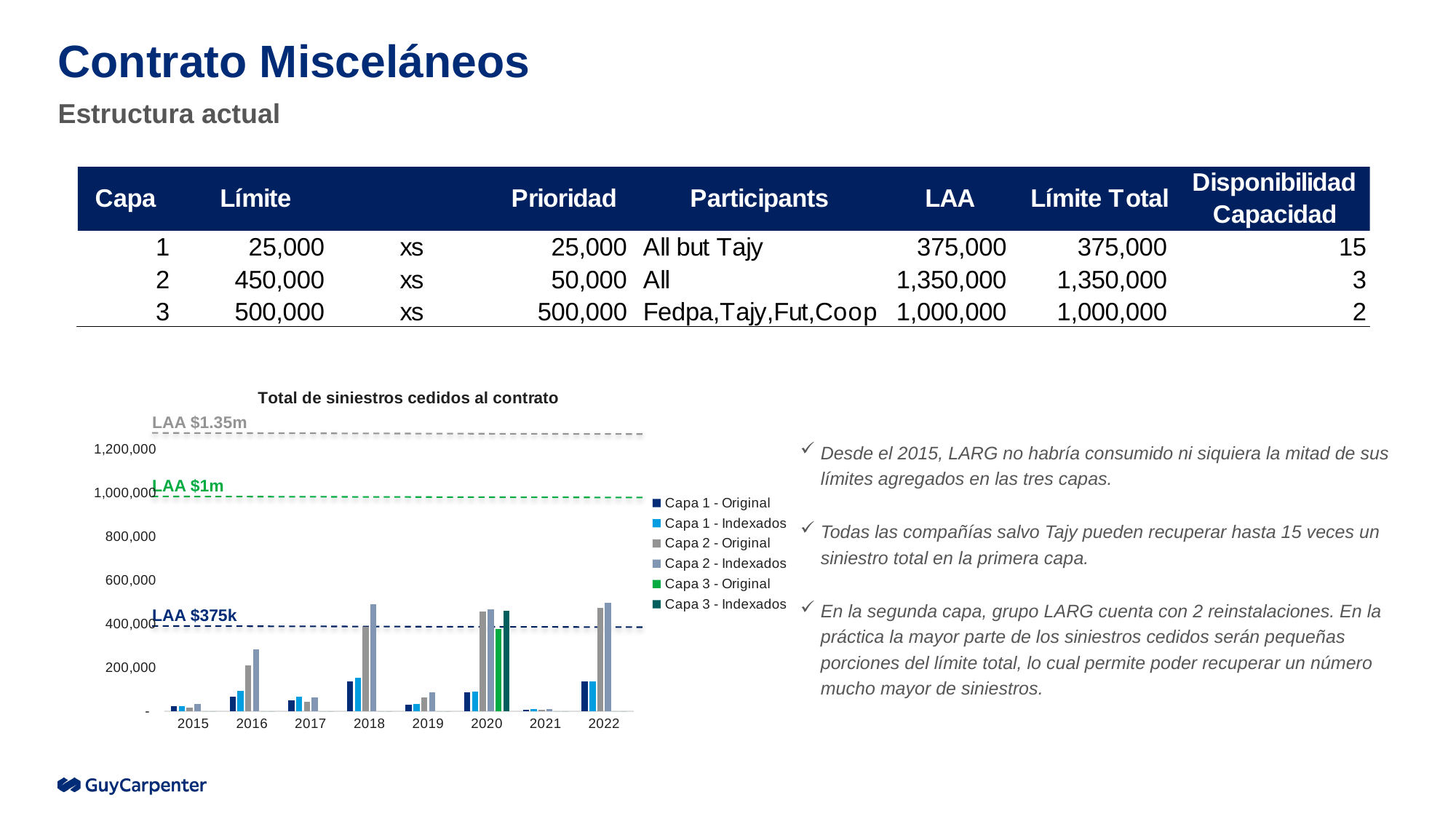
Is the value for Capa 2 - Indexados in 2018 greater or less than 400,000? greater Which year has the lowest value for Capa 2 - Indexados? 2021 Which is larger, the Capa 1 - Original value in 2018 or in 2019? 2018 What kind of chart is shown on the slide? bar chart What is the title of the chart on the slide? Total de siniestros cedidos al contrato What is the label of the topmost dashed reference line on the chart? LAA $1.35m Is the value for Capa 2 - Indexados in 2016 greater or less than 400,000? less Is the value for Capa 1 - Original in 2018 greater or less than 200,000? less How many years are shown along the x axis of the chart? 8 How many series does the chart's legend list? 6 Which is larger, the Capa 2 - Indexados value in 2016 or in 2017? 2016